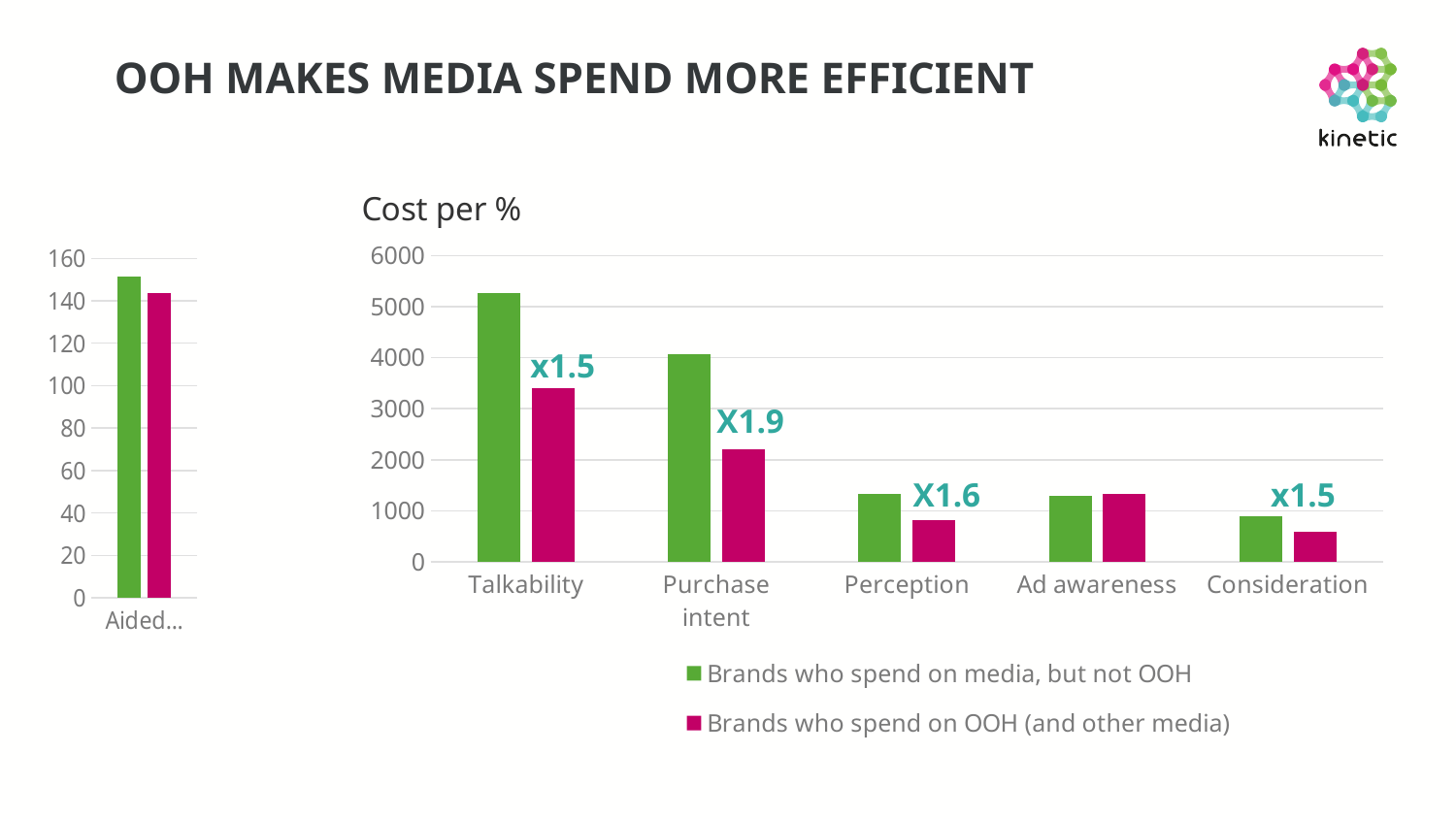
In the 'Cost per %' chart, which category has the lowest value for 'Brands who spend on OOH (and other media)'? Consideration In the 'Cost per %' chart, what kind of chart is shown? bar chart In the 'Cost per %' chart, what multiplier label is printed above the Purchase intent bars? X1.9 In the 'Cost per %' chart, how many series does the legend list? 2 In the 'Cost per %' chart, is the value for Talkability for 'Brands who spend on media, but not OOH' greater or less than 5000? greater In the small chart on the left of the slide, is the value of the green bar greater or less than 140? greater In the 'Cost per %' chart, how many categories are shown on the x axis? 5 In the 'Cost per %' chart, what colour are the bars for 'Brands who spend on OOH (and other media)'? pink In the 'Cost per %' chart, for Talkability, which series has the larger value: 'Brands who spend on media, but not OOH' or 'Brands who spend on OOH (and other media)'? Brands who spend on media, but not OOH In the 'Cost per %' chart, is the value for Perception for 'Brands who spend on OOH (and other media)' greater or less than 1000? less In the 'Cost per %' chart, which category has the highest value for 'Brands who spend on media, but not OOH'? Talkability